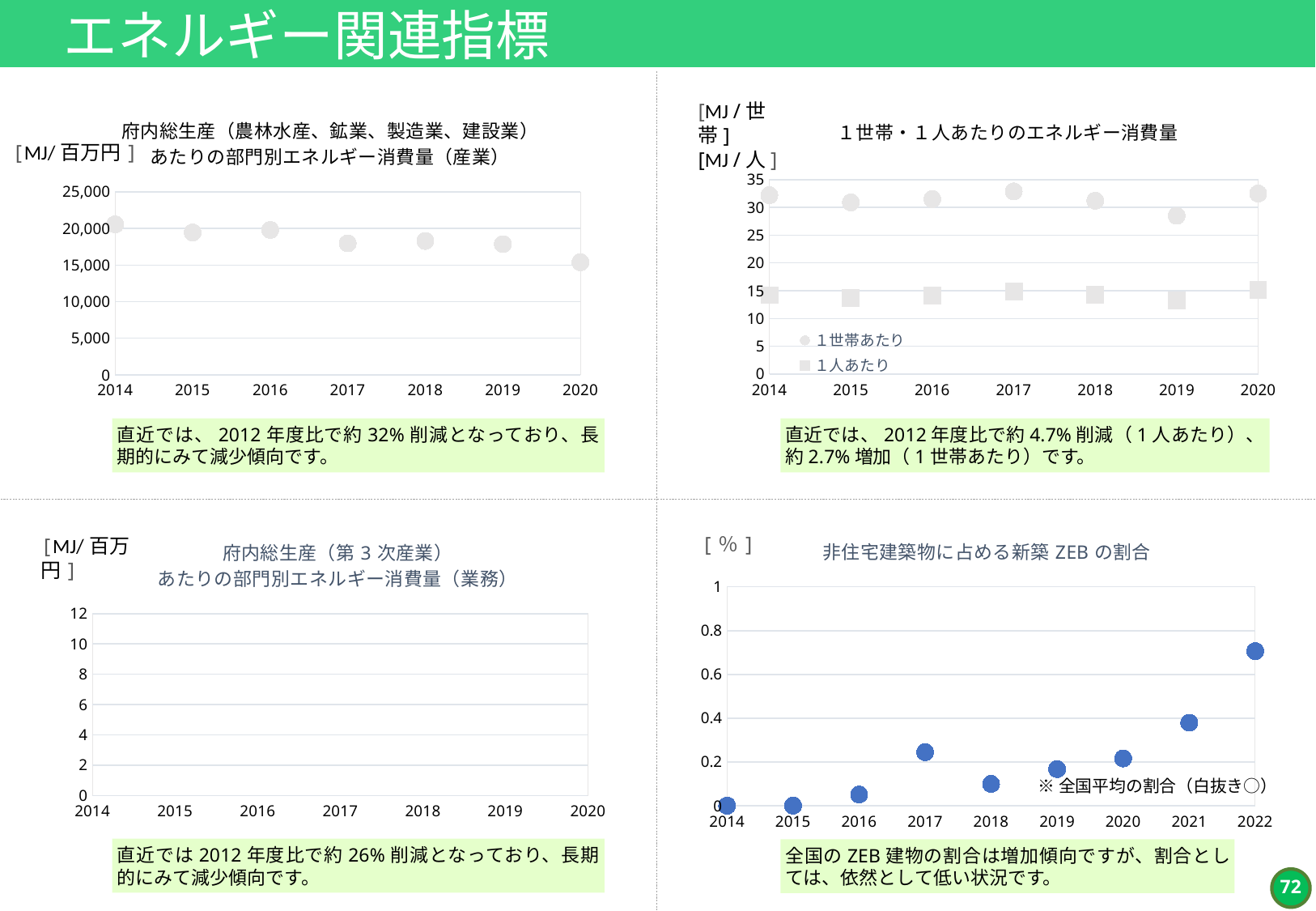
In the top-left chart (府内総生産（農林水産、鉱業、製造業、建設業）あたりの部門別エネルギー消費量（産業）), is the value for 2014 greater or less than 20,000? greater In the bottom-right chart (非住宅建築物に占める新築ZEBの割合), which year has the highest value? 2022 In the bottom-right chart (非住宅建築物に占める新築ZEBの割合), is the value for 2022 greater or less than 0.6? greater How many series does the legend list in the top-right chart (１世帯・１人あたりのエネルギー消費量)? 2 How many years are plotted in the top-left chart (府内総生産（農林水産、鉱業、製造業、建設業）あたりの部門別エネルギー消費量（産業）)? 7 In the top-left chart (府内総生産（農林水産、鉱業、製造業、建設業）あたりの部門別エネルギー消費量（産業）), do the values generally rise or fall from 2014 to 2020? fall In the top-right chart (１世帯・１人あたりのエネルギー消費量), which series has the larger value in 2020, １世帯あたり or １人あたり? １世帯あたり In the top-left chart (府内総生産（農林水産、鉱業、製造業、建設業）あたりの部門別エネルギー消費量（産業）), which year has the highest value? 2014 In the top-left chart (府内総生産（農林水産、鉱業、製造業、建設業）あたりの部門別エネルギー消費量（産業）), which year has the lowest value? 2020 In the top-right chart (１世帯・１人あたりのエネルギー消費量), is the value for １人あたり in 2019 greater or less than 15? less How many years are plotted in the bottom-right chart (非住宅建築物に占める新築ZEBの割合)? 9